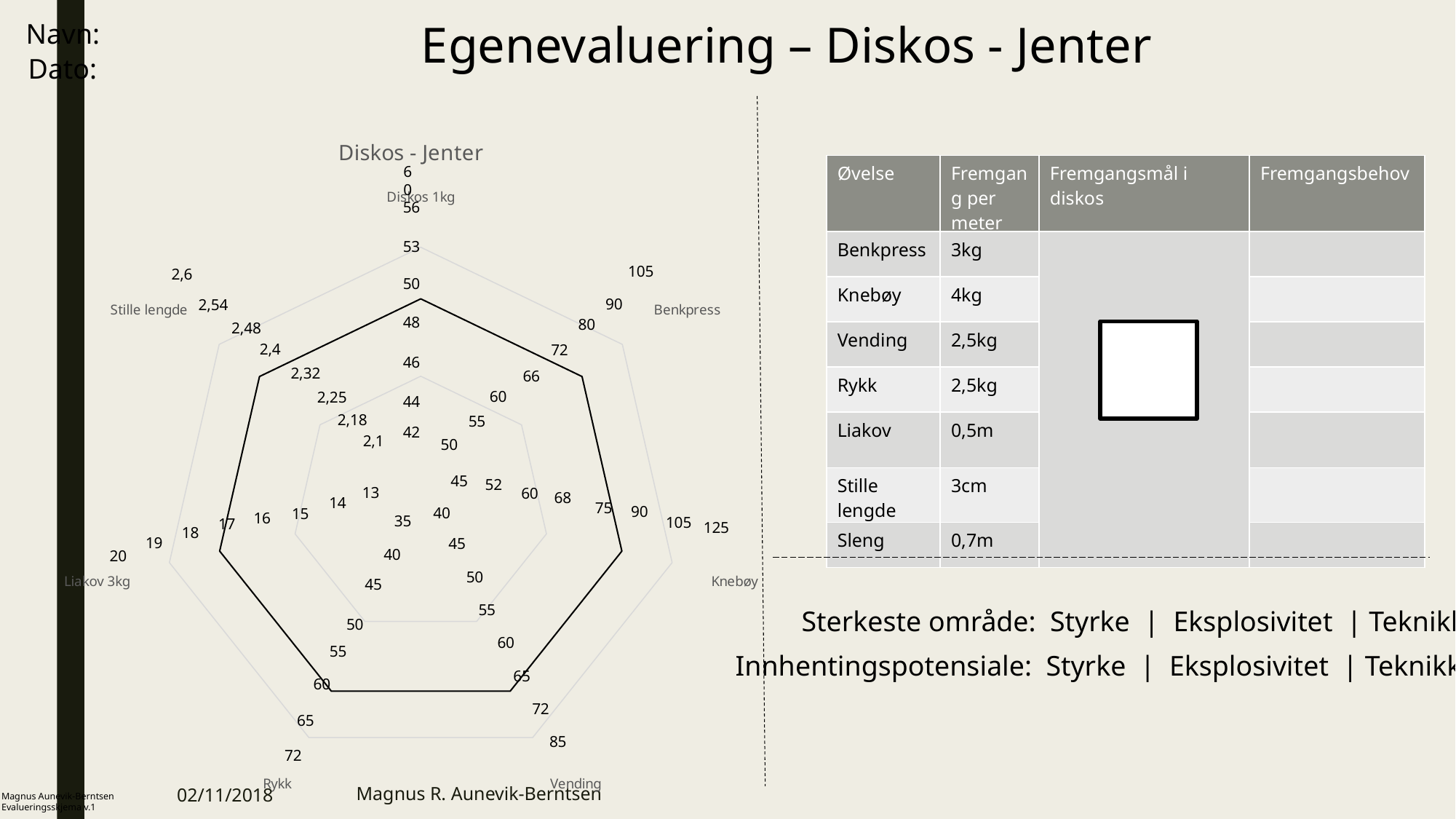
What is the title of the chart? Diskos - Jenter Is the value for Rykk greater or less than 72? less Is the value for Benkpress greater or less than 60? greater Is the value for Diskos 1kg greater or less than 56? less How many axes (categories) does the radar chart have? 7 What kind of chart is shown on the slide? Radar chart